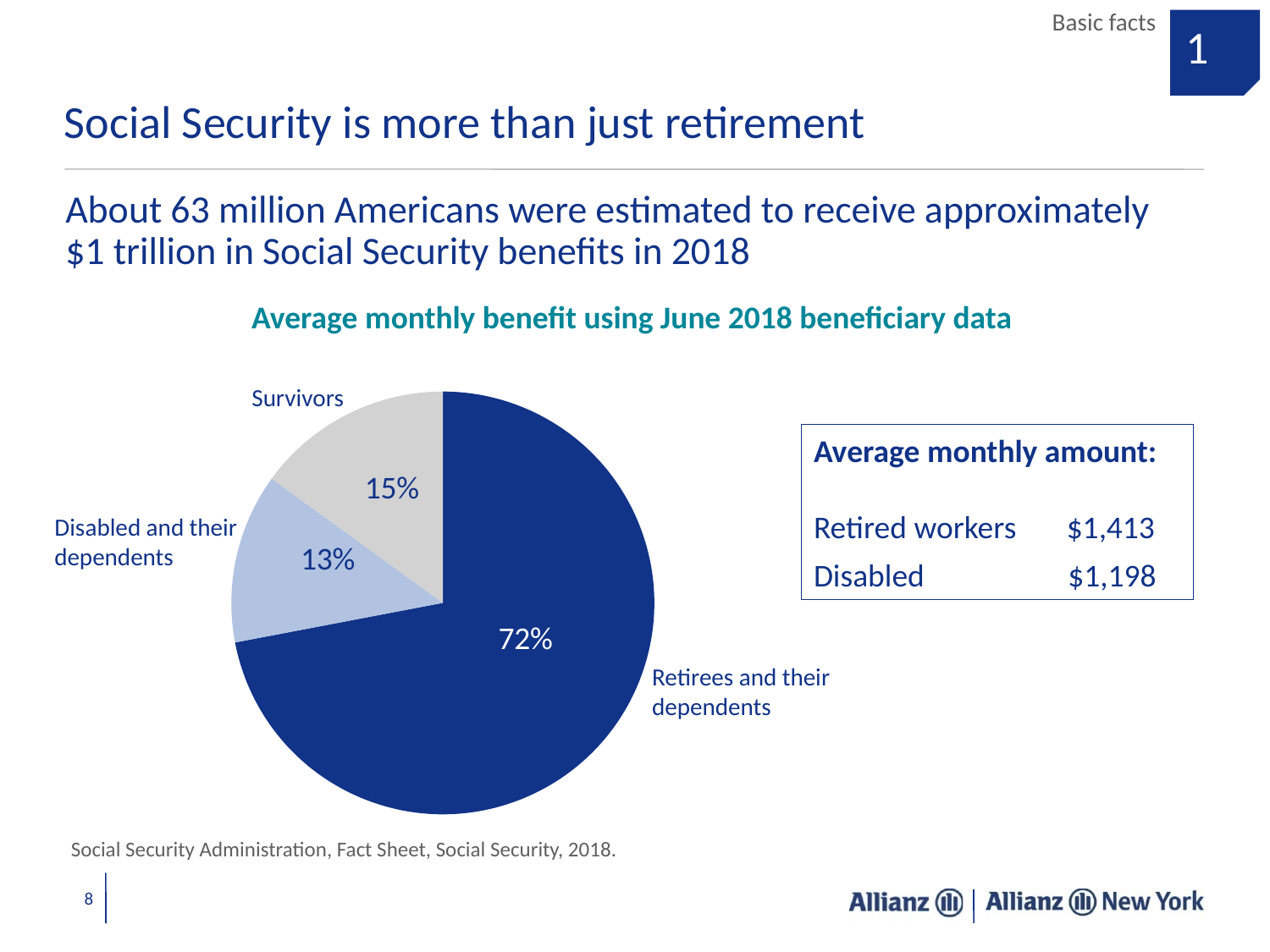
What share of the pie is labelled for Survivors? 15% What is the difference in percentage points between the Retirees and their dependents slice and the Survivors slice? 57 What is the title of the chart? Average monthly benefit using June 2018 beneficiary data What is the difference in percentage points between the Survivors slice and the Disabled and their dependents slice? 2 What share of the pie is labelled for Disabled and their dependents? 13% Which slice of the pie is the smallest? Disabled and their dependents What colour is the Survivors slice of the pie? grey What share of the pie is labelled for Retirees and their dependents? 72% How many slices does the pie chart have? 3 Which is larger, the Survivors slice or the Disabled and their dependents slice? Survivors What kind of chart is shown on the slide? pie chart Which slice of the pie is the largest? Retirees and their dependents